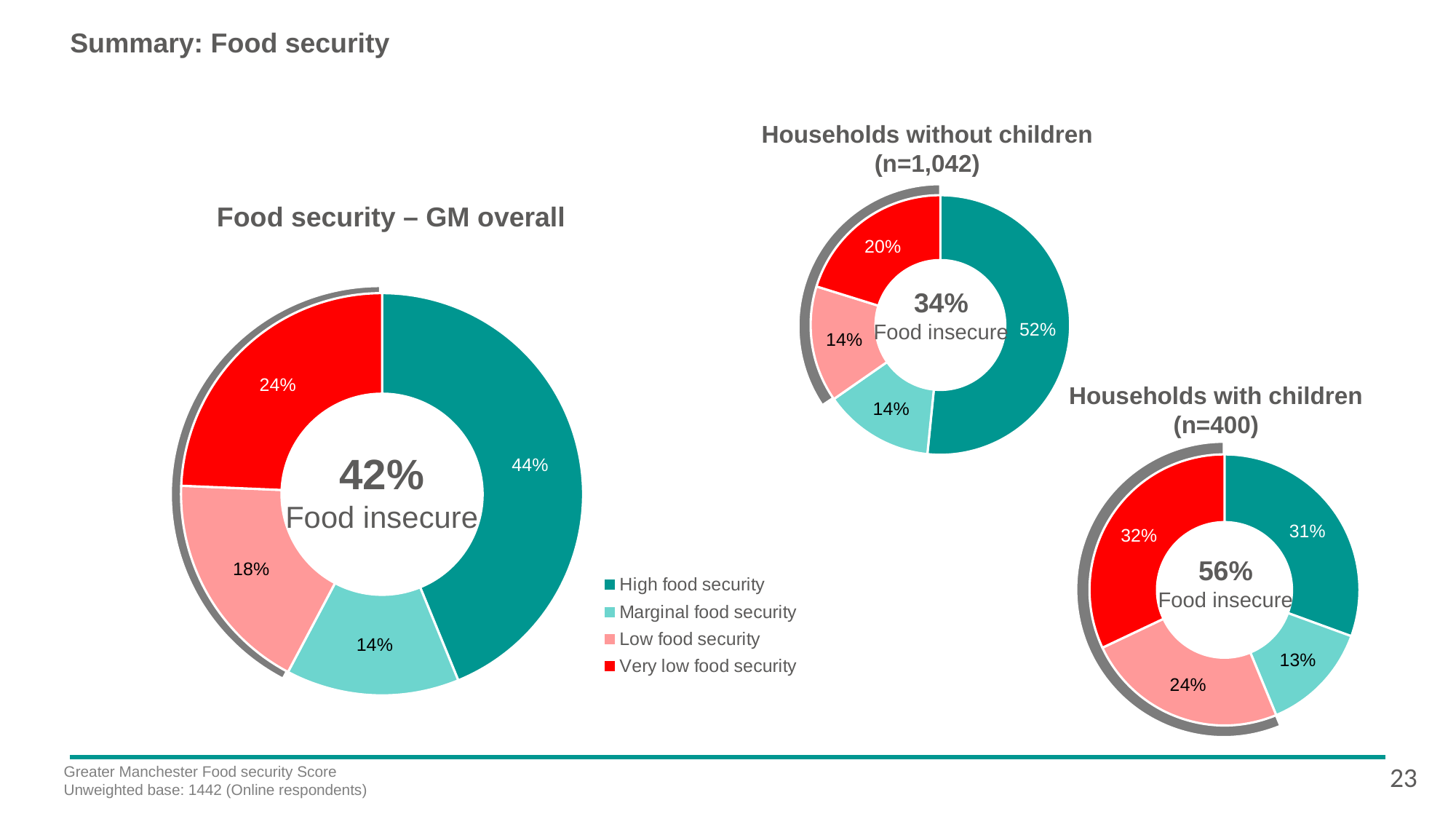
In the 'Households without children (n=1,042)' chart, what is the combined share of Low food security and Very low food security? 34% In the 'Households with children (n=400)' chart, which is larger: Very low food security or High food security? Very low food security In the 'Households without children (n=1,042)' chart, which category has the largest share? High food security What percentage of households with children are labelled as food insecure in the centre of the 'Households with children (n=400)' chart? 56% In the 'Households with children (n=400)' chart, what percentage is shown for Very low food security? 32% In the 'Food security – GM overall' chart, what percentage is shown for High food security? 44% In the 'Food security – GM overall' chart, what is the difference between the Very low food security and Low food security percentages? 6% In the 'Households without children (n=1,042)' chart, what percentage is shown for High food security? 52% What kind of chart is 'Food security – GM overall'? Pie (donut) chart How many categories does the legend list? 4 In the 'Households with children (n=400)' chart, which category has the smallest share? Marginal food security In the 'Food security – GM overall' chart, what percentage is shown for Very low food security? 24%